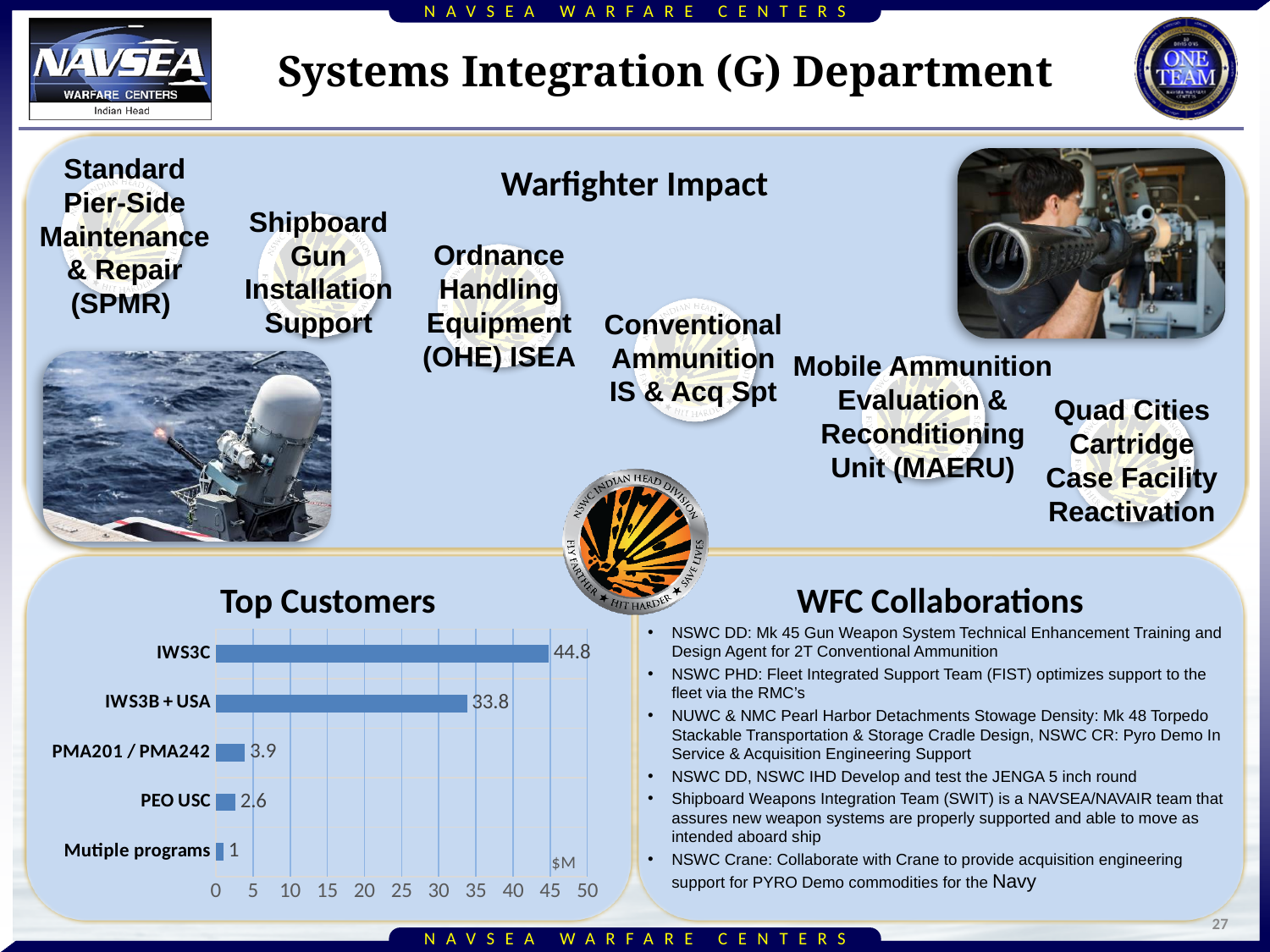
Which customer has the highest value in the Top Customers chart? IWS3C What is the value for IWS3B + USA in the Top Customers chart? 33.8 Which category has the lowest value in the Top Customers chart? Mutiple programs What is the value for PEO USC in the Top Customers chart? 2.6 In the Top Customers chart, which is larger: PMA201 / PMA242 or PEO USC? PMA201 / PMA242 What is the difference between the values for IWS3C and IWS3B + USA in the Top Customers chart? 11 What is the value for PMA201 / PMA242 in the Top Customers chart? 3.9 What unit label is shown on the axis of the Top Customers chart? $M How many customer categories are shown in the Top Customers chart? 5 Is the value for IWS3B + USA in the Top Customers chart greater or less than 30? greater What kind of chart is the Top Customers chart? bar chart What is the value for IWS3C in the Top Customers chart? 44.8